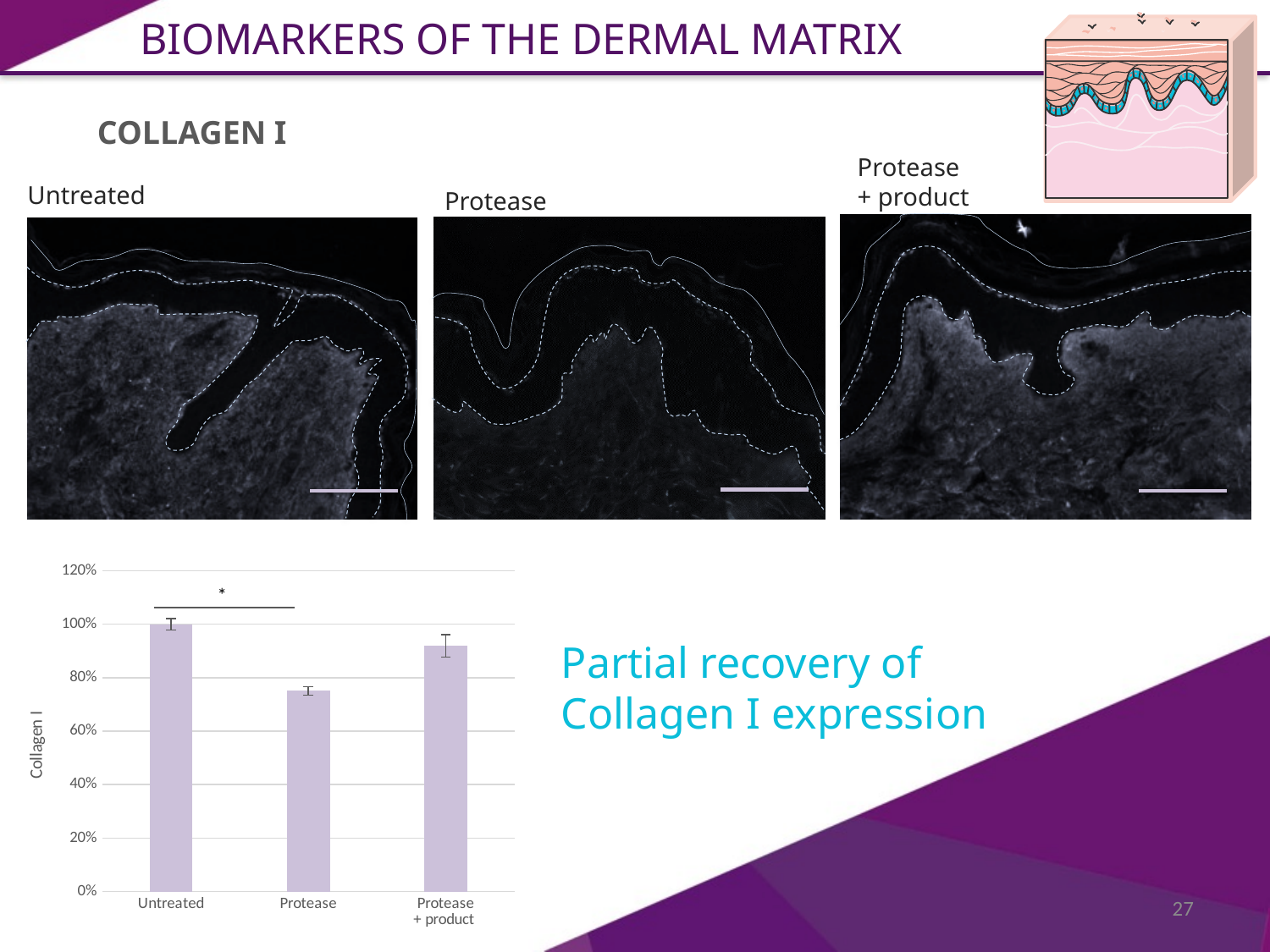
Is the value for Protease greater or less than 60%? greater Which category has the highest bar in the Collagen I chart? Untreated What is the highest value shown on the y axis of the bar chart? 120% Is the value for Protease + product greater or less than 80%? greater Which is larger in the Collagen I chart, the value for Protease or the value for Protease + product? Protease + product Which is larger in the Collagen I chart, the value for Untreated or the value for Protease? Untreated What is the value for Untreated in the Collagen I chart? 100% What kind of chart is shown at the bottom left of the slide? bar chart Which category has the lowest bar in the Collagen I chart? Protease Is the value for Protease greater or less than 80%? less What is the label on the y axis of the bar chart? Collagen I How many categories are plotted on the x axis of the bar chart? 3